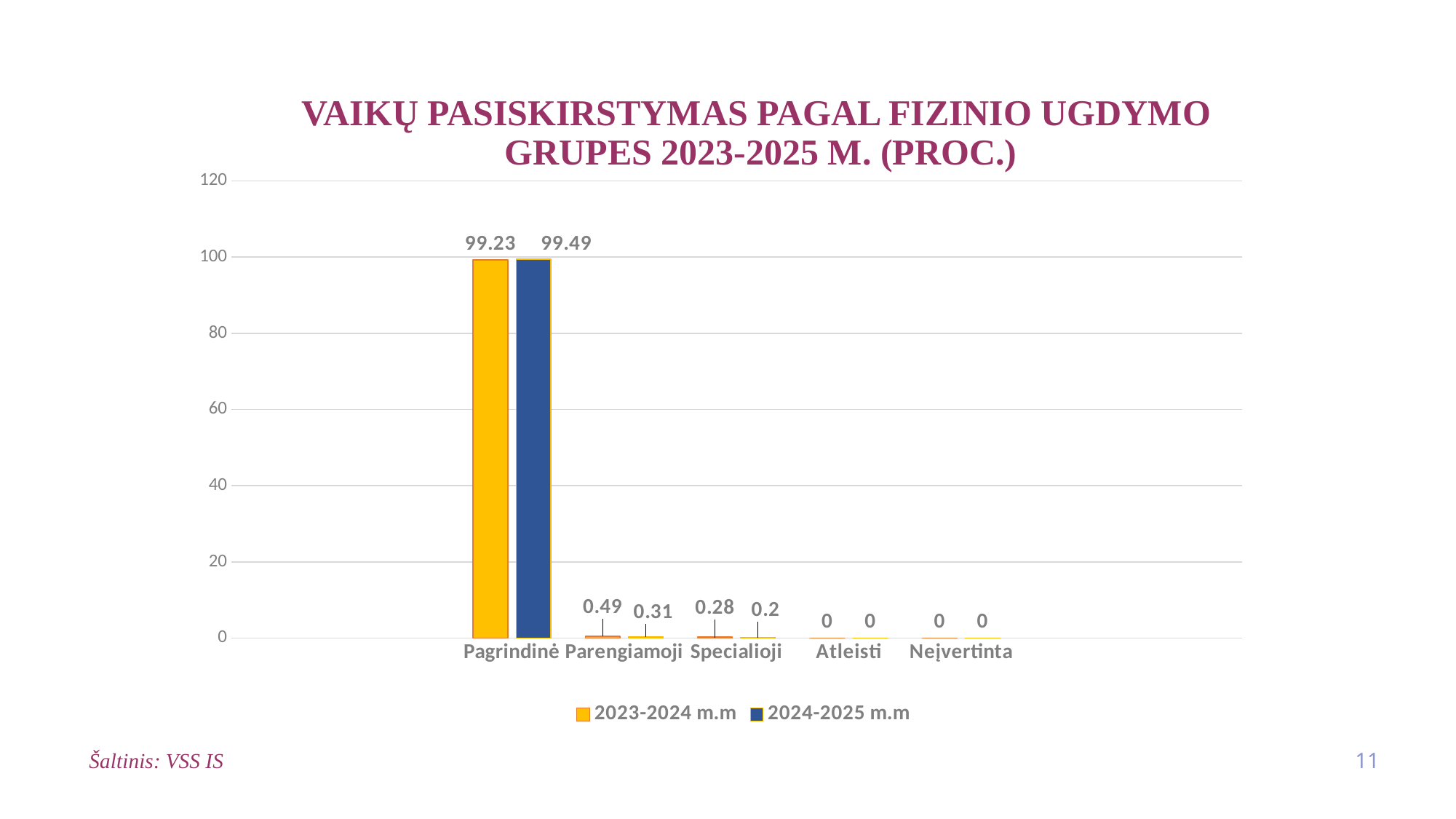
What is the value for Parengiamoji in the 2023-2024 m.m series? 0.49 What is the value for Pagrindinė in the 2023-2024 m.m series? 99.23 What kind of chart is shown on the slide? Bar chart For Specialioji, which series has the larger value: 2023-2024 m.m or 2024-2025 m.m? 2023-2024 m.m What is the difference between the 2024-2025 m.m and 2023-2024 m.m values for Pagrindinė? 0.26 What is the difference between the 2023-2024 m.m and 2024-2025 m.m values for Parengiamoji? 0.18 Which category has the highest value in the 2024-2025 m.m series? Pagrindinė How many series does the legend list? 2 What is the value for Specialioji in the 2024-2025 m.m series? 0.2 What is the value for Atleisti in the 2024-2025 m.m series? 0 What is the value for Pagrindinė in the 2024-2025 m.m series? 99.49 How many categories are shown on the x axis? 5